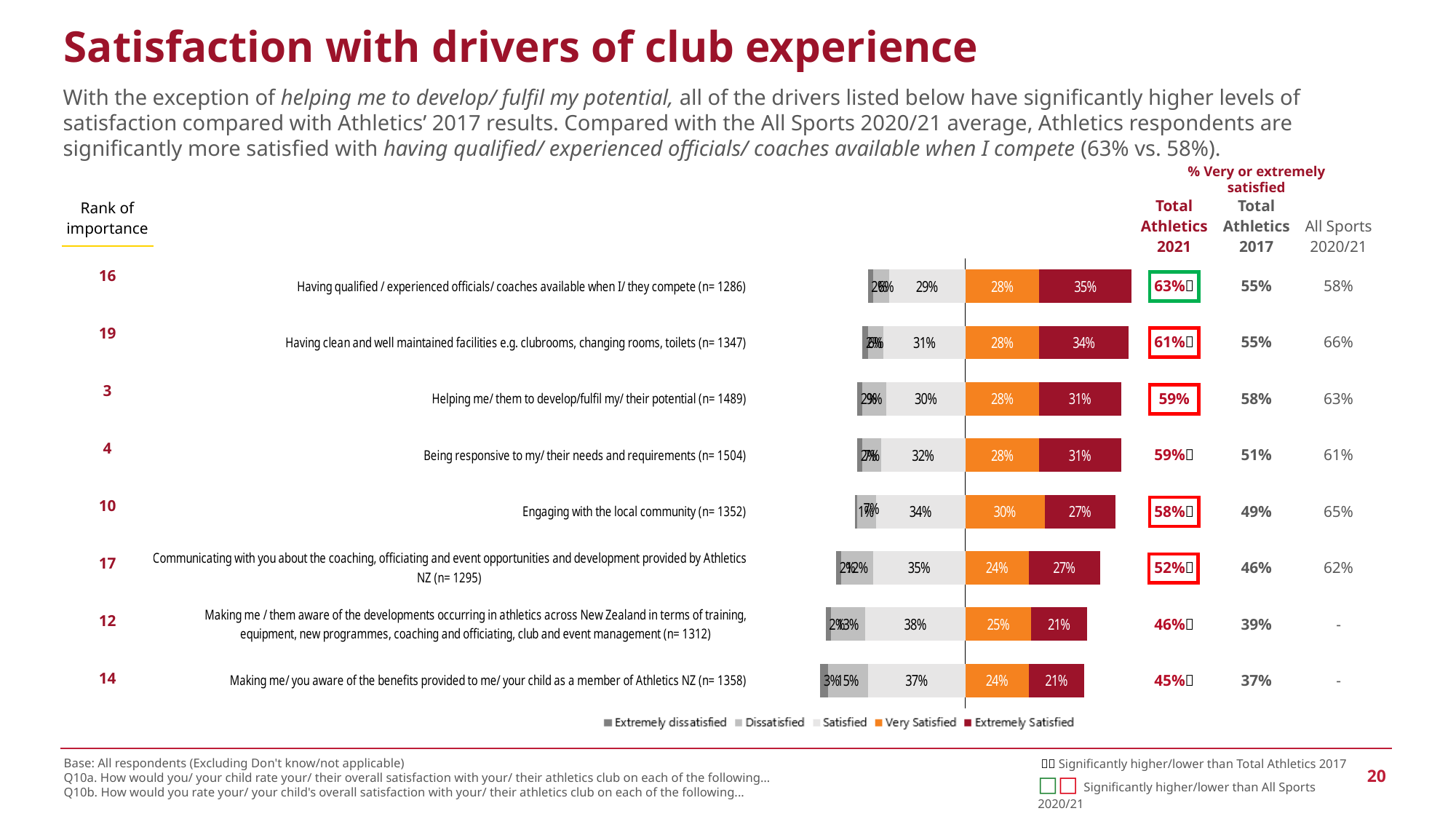
What is the combined Very Satisfied and Extremely Satisfied total for 'Helping me/ them to develop/fulfil my/ their potential'? 59% Which driver has the highest Extremely Satisfied value? Having qualified / experienced officials/ coaches available when I/ they compete What is the Extremely Satisfied value for 'Having qualified / experienced officials/ coaches available when I/ they compete'? 35% Which driver has the highest Very Satisfied value? Engaging with the local community What is the Satisfied value for 'Making me / them aware of the developments occurring in athletics across New Zealand'? 38% What is the Total Athletics 2017 value for 'Engaging with the local community'? 49% What colour represents the Very Satisfied series in the chart? Orange How many series does the chart legend list? 5 What kind of chart is shown on the slide? Stacked bar chart For 'Engaging with the local community', what is the difference between the Very Satisfied and Extremely Satisfied values? 3 percentage points Which has the larger Satisfied value: 'Having qualified / experienced officials/ coaches available' or 'Making me/ you aware of the benefits provided to me/ your child as a member of Athletics NZ'? Making me/ you aware of the benefits provided to me/ your child as a member of Athletics NZ How many drivers (categories) are plotted in the chart? 8